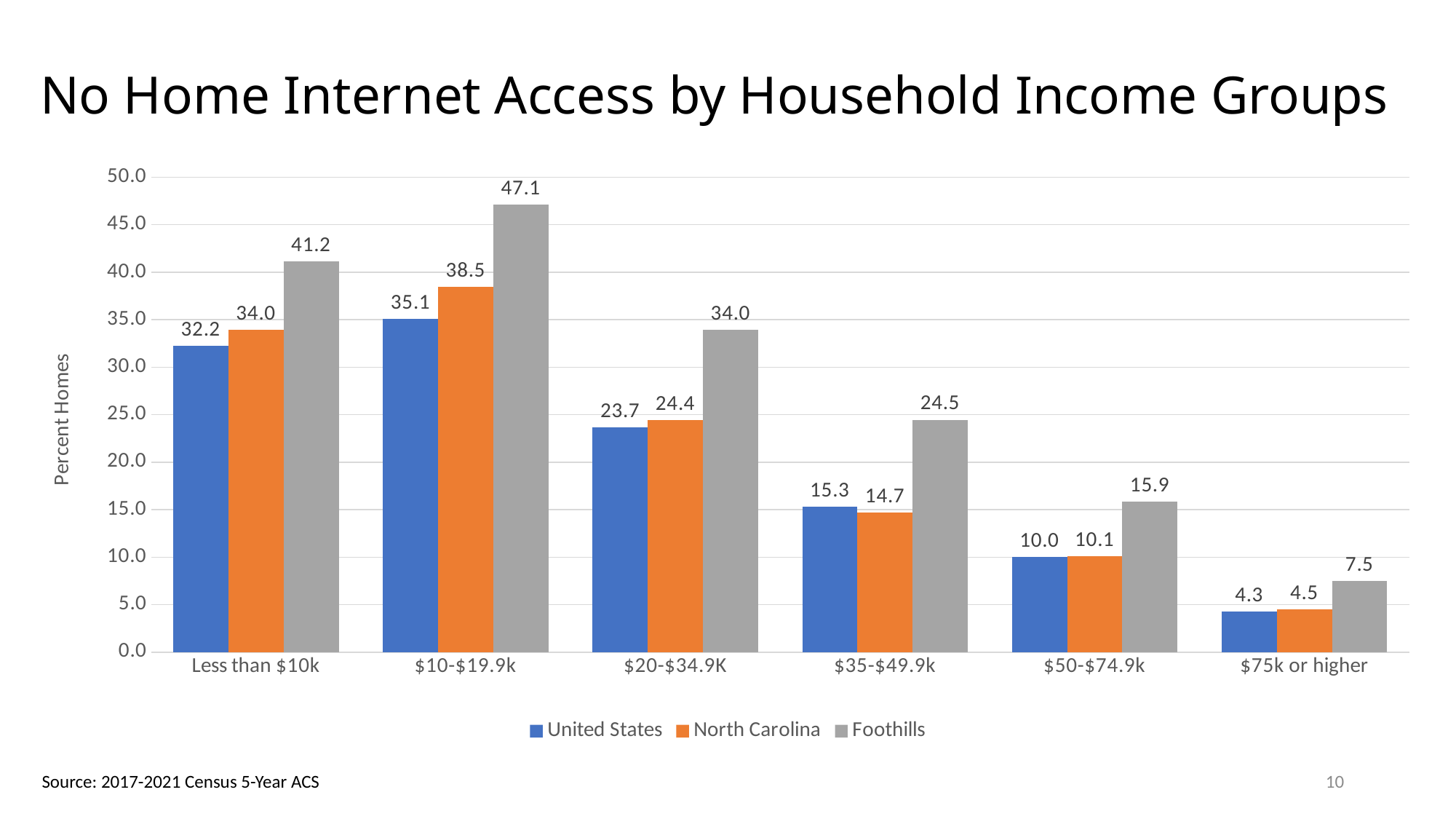
What is the difference between the Foothills and United States values for the $20-$34.9K income group? 10.3 What is the label of the y axis? Percent Homes How many income groups are shown on the x axis? 6 How many series does the legend list? 3 What is the Foothills value for the $10-$19.9k income group? 47.1 For the $50-$74.9k income group, which is larger: the United States value or the Foothills value? Foothills Which income group has the highest Foothills value? $10-$19.9k What kind of chart is shown on the slide? Bar chart Do the Foothills values rise or fall from the $10-$19.9k group to the $75k or higher group? Fall What is the North Carolina value for the $35-$49.9k income group? 14.7 What is the United States value for the Less than $10k income group? 32.2 Which income group has the lowest United States value? $75k or higher